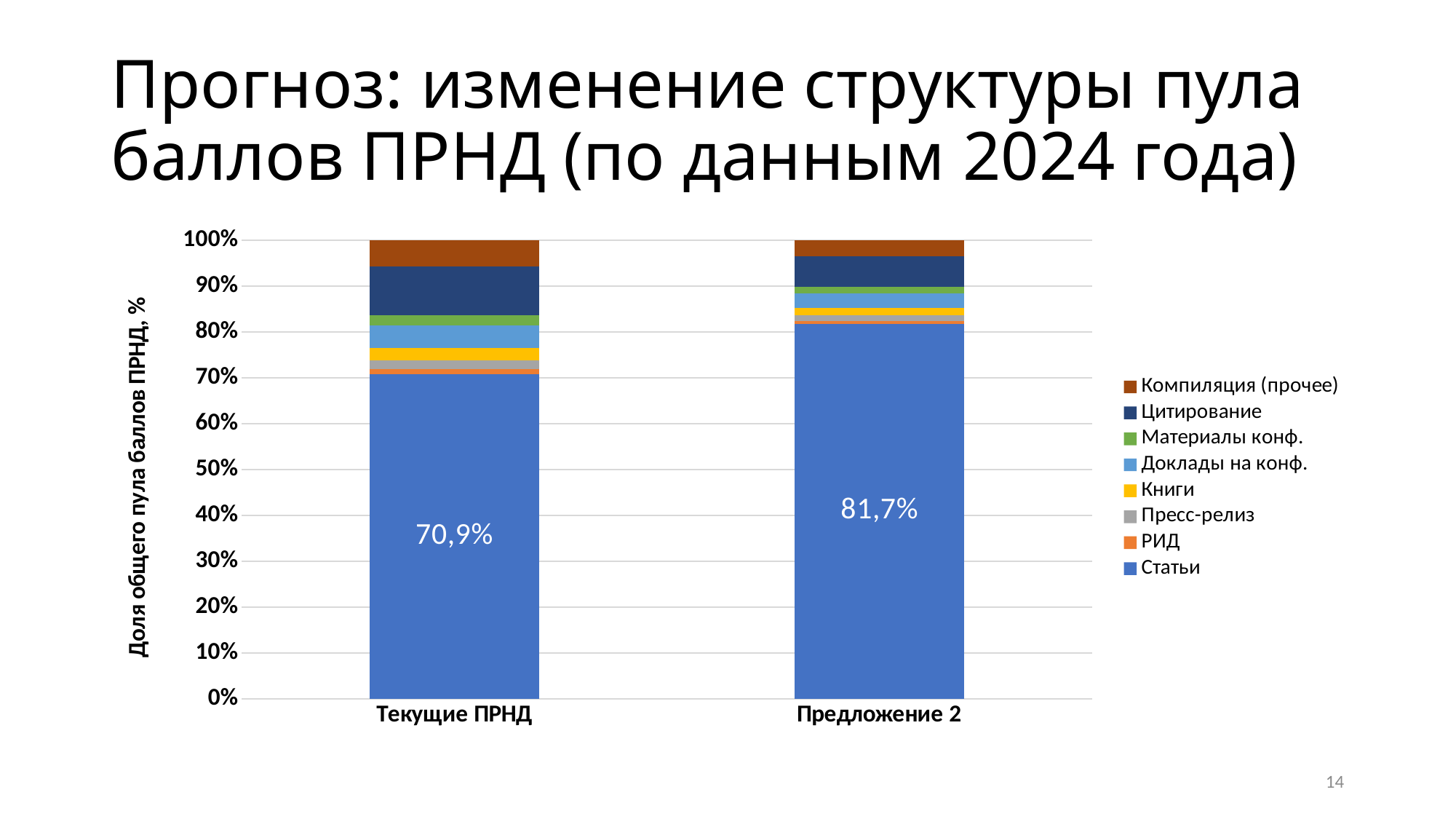
How many series does the legend list? 8 What share of the total pool do Статьи make up in the Текущие ПРНД bar? 70,9% In which bar is the Цитирование segment larger, Текущие ПРНД or Предложение 2? Текущие ПРНД Does the Статьи share rise or fall from Текущие ПРНД to Предложение 2? Rises What is the y-axis title of the chart? Доля общего пула баллов ПРНД, % Which series is listed first (at the top) in the legend? Компиляция (прочее) How many bars (categories) are shown on the x axis? 2 Which bar has the larger Статьи share, Текущие ПРНД or Предложение 2? Предложение 2 Is the Цитирование segment in the Предложение 2 bar greater or less than 10% of the total? less What share of the total pool do Статьи make up in the Предложение 2 bar? 81,7% By how many percentage points does the Статьи share in Предложение 2 exceed the Статьи share in Текущие ПРНД? 10,8% What kind of chart is shown on the slide? Stacked bar chart